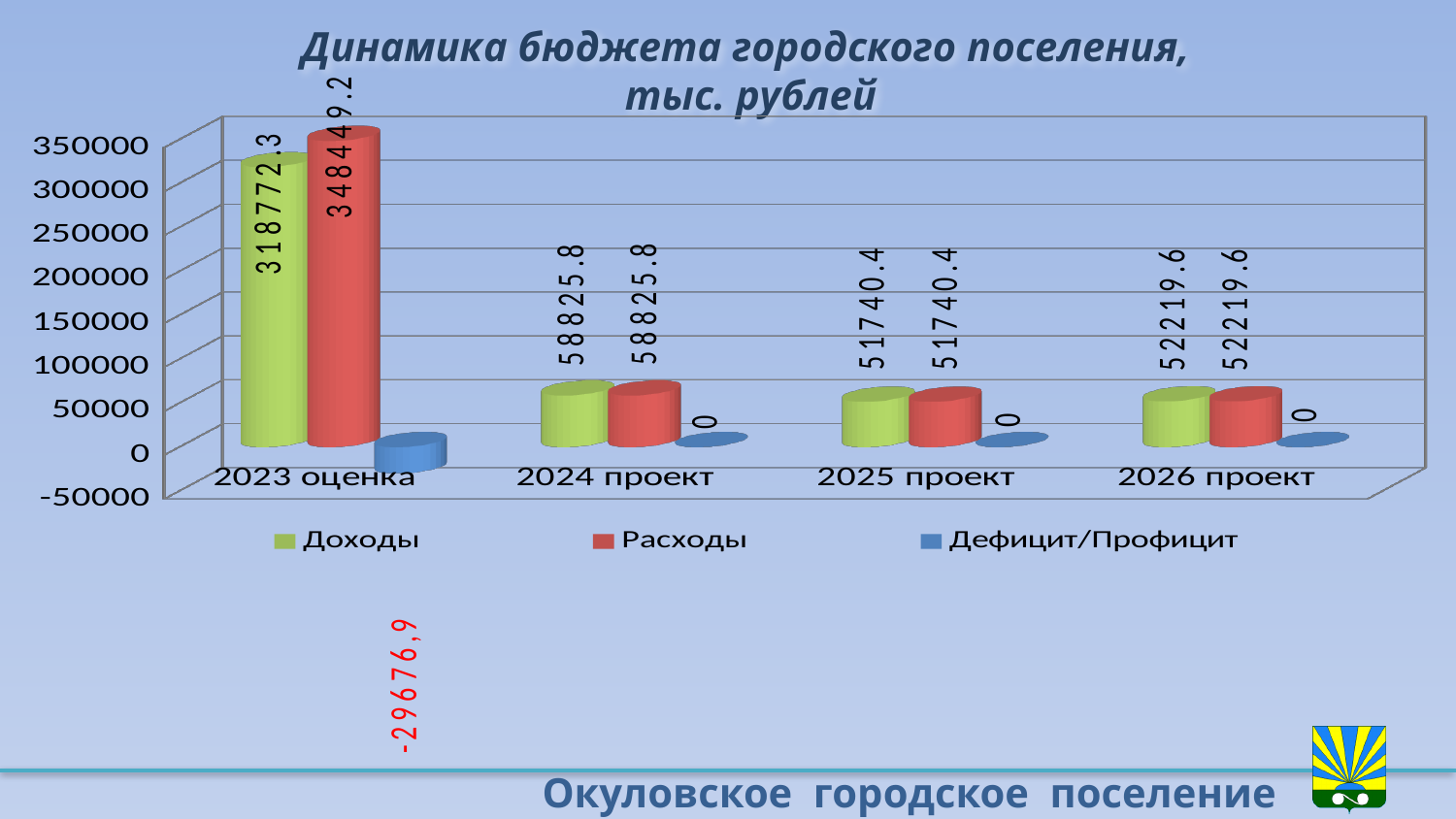
What is the difference between Расходы and Доходы for 2023 оценка? 29676.9 What is the value of Доходы for 2023 оценка? 318772.3 How many categories are shown on the x axis? 4 Which is larger for 2023 оценка: Доходы or Расходы? Расходы Which category has the lowest value of Доходы? 2025 проект What is the value of Расходы for 2026 проект? 52219.6 How many series does the legend list? 3 What is the value of Дефицит/Профицит for 2024 проект? 0 Which category has the highest value of Расходы? 2023 оценка What is the value of Доходы for 2025 проект? 51740.4 What is the value of Расходы for 2023 оценка? 348449.2 What kind of chart is shown on the slide? Bar chart